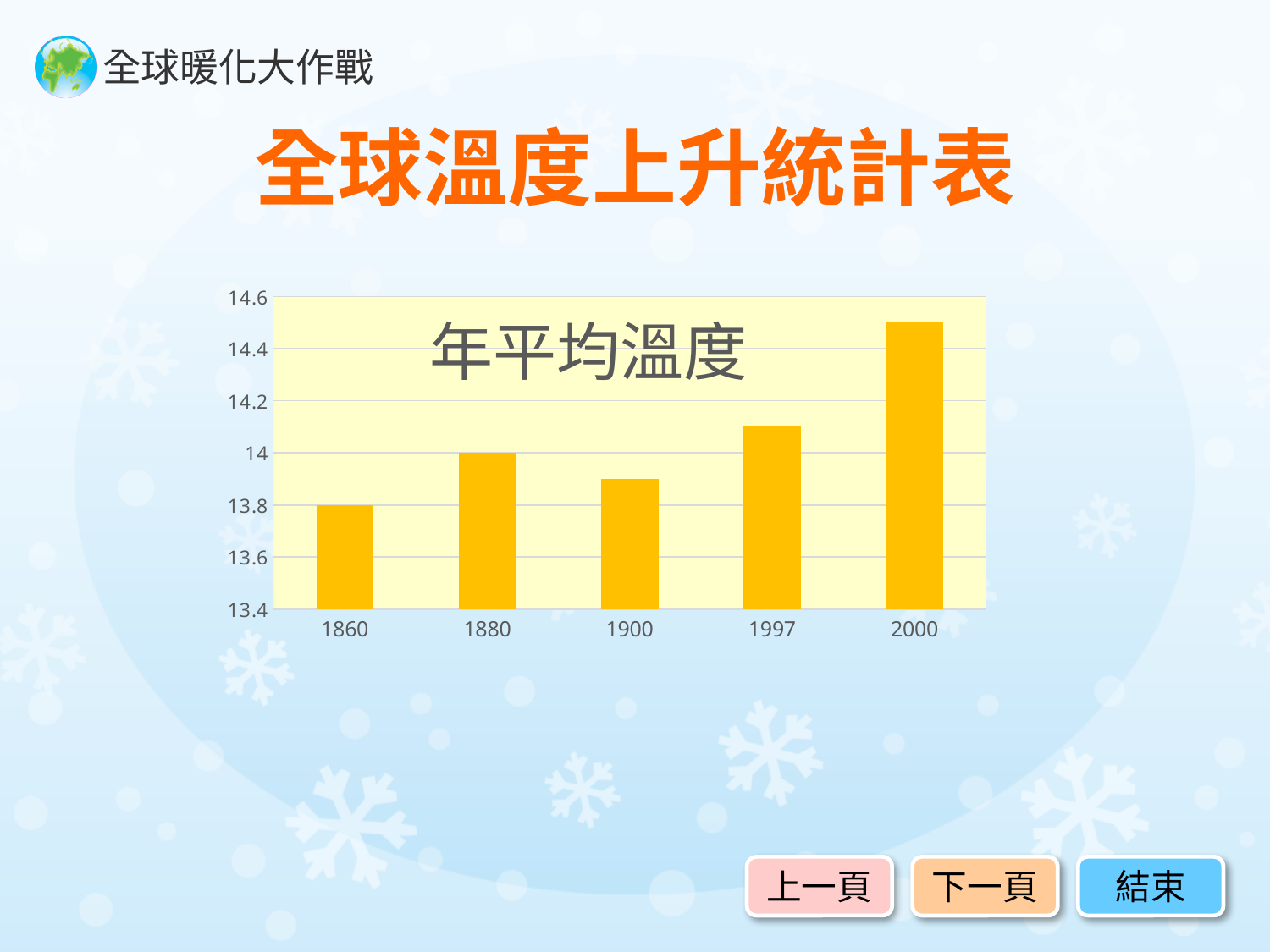
What is the value for 1880 in the 年平均溫度 chart? 14 What is the title shown inside the chart on the slide? 年平均溫度 Is the value for 1900 in the 年平均溫度 chart greater or less than 14? less Which year has the highest value in the 年平均溫度 chart? 2000 Is the value for 1997 in the 年平均溫度 chart greater or less than 14? greater Which is larger in the 年平均溫度 chart, the value for 1997 or the value for 1880? 1997 What is the value for 1860 in the 年平均溫度 chart? 13.8 What is the difference between the values for 1880 and 1860 in the 年平均溫度 chart? 0.2 Is the value for 2000 in the 年平均溫度 chart greater or less than 14.4? greater What kind of chart is the 年平均溫度 chart? bar chart Which year has the lowest value in the 年平均溫度 chart? 1860 How many years are shown on the x axis of the 年平均溫度 chart? 5